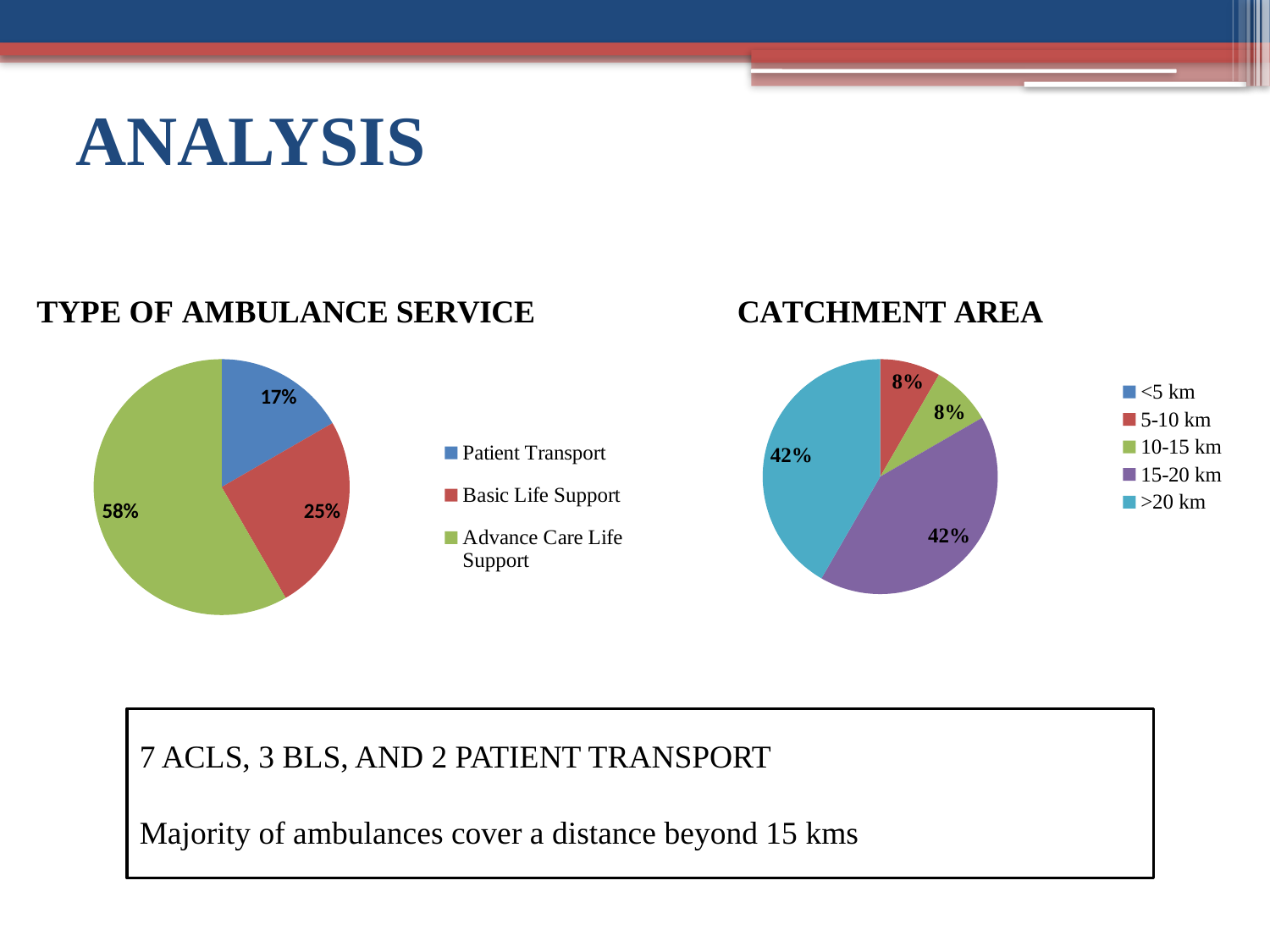
In the CATCHMENT AREA chart, which is larger, >20 km or 10-15 km? >20 km In the CATCHMENT AREA chart, what share does 5-10 km have? 8% In the TYPE OF AMBULANCE SERVICE chart, what is the difference between the Advance Care Life Support and Basic Life Support shares? 33% How many entries does the legend of the CATCHMENT AREA chart list? 5 In the CATCHMENT AREA chart, what share does 15-20 km have? 42% In the TYPE OF AMBULANCE SERVICE chart, which is larger, Basic Life Support or Patient Transport? Basic Life Support In the TYPE OF AMBULANCE SERVICE chart, what share does Advance Care Life Support have? 58% In the TYPE OF AMBULANCE SERVICE chart, which category has the smallest slice? Patient Transport What kind of chart is the CATCHMENT AREA chart? Pie chart In the TYPE OF AMBULANCE SERVICE chart, which category has the largest slice? Advance Care Life Support